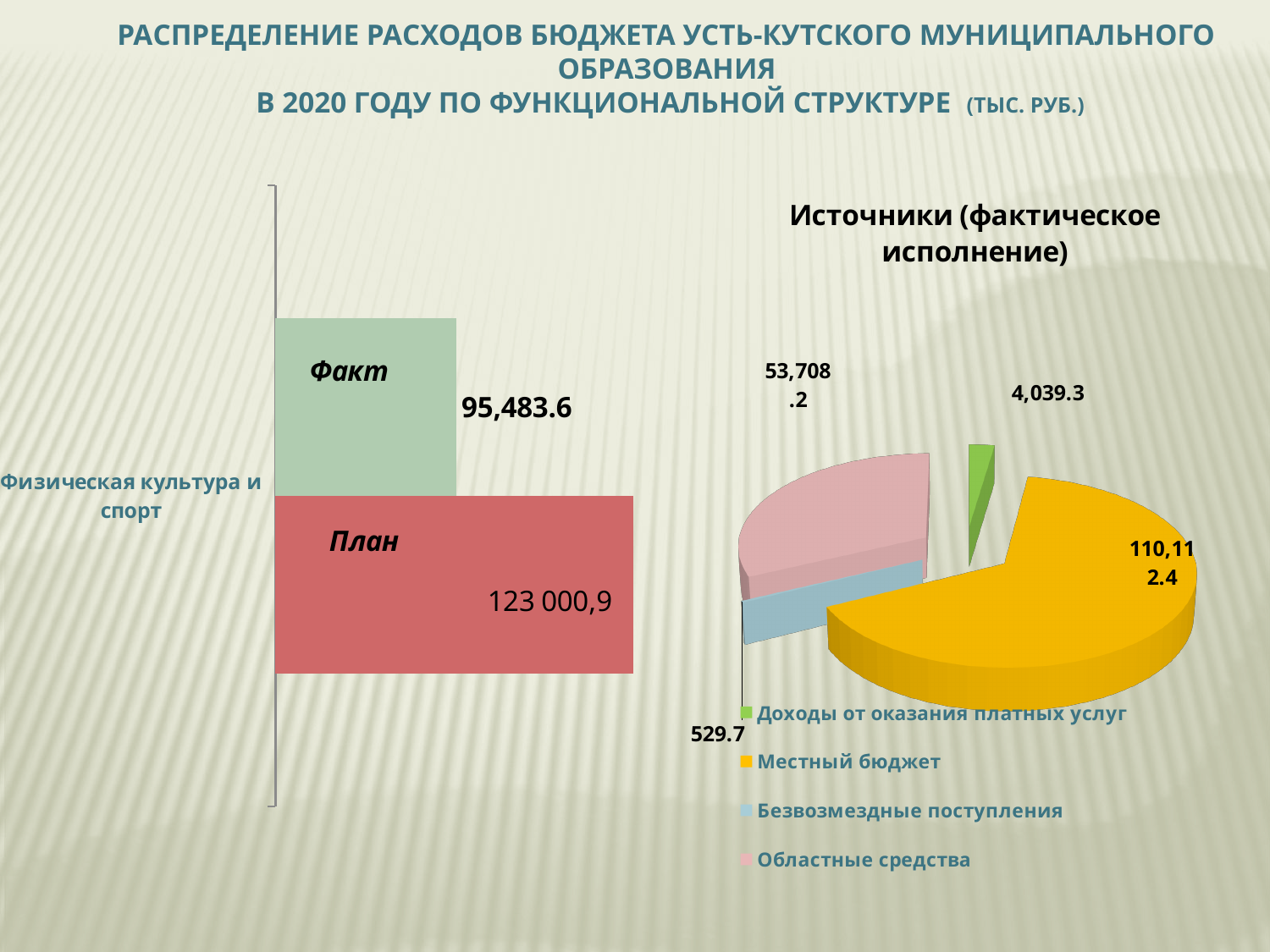
In the pie chart Источники (фактическое исполнение), which source has the smallest value? Безвозмездные поступления In the pie chart Источники (фактическое исполнение), what is the value for Безвозмездные поступления? 529.7 In the pie chart Источники (фактическое исполнение), what is the value for Областные средства? 53,708.2 What kind of chart is the chart titled Источники (фактическое исполнение)? pie chart In the pie chart Источники (фактическое исполнение), what is the value for Местный бюджет? 110,112.4 On the left bar chart, what is the value of the Факт bar for Физическая культура и спорт? 95,483.6 In the pie chart Источники (фактическое исполнение), which source has the largest value? Местный бюджет In the pie chart Источники (фактическое исполнение), what is the value for Доходы от оказания платных услуг? 4,039.3 What kind of chart is the chart on the left of the slide? bar chart On the left bar chart, what is the value of the План bar for Физическая культура и спорт? 123 000,9 How many entries does the legend of the pie chart Источники (фактическое исполнение) list? 4 On the left bar chart, which bar is larger, Факт or План? План